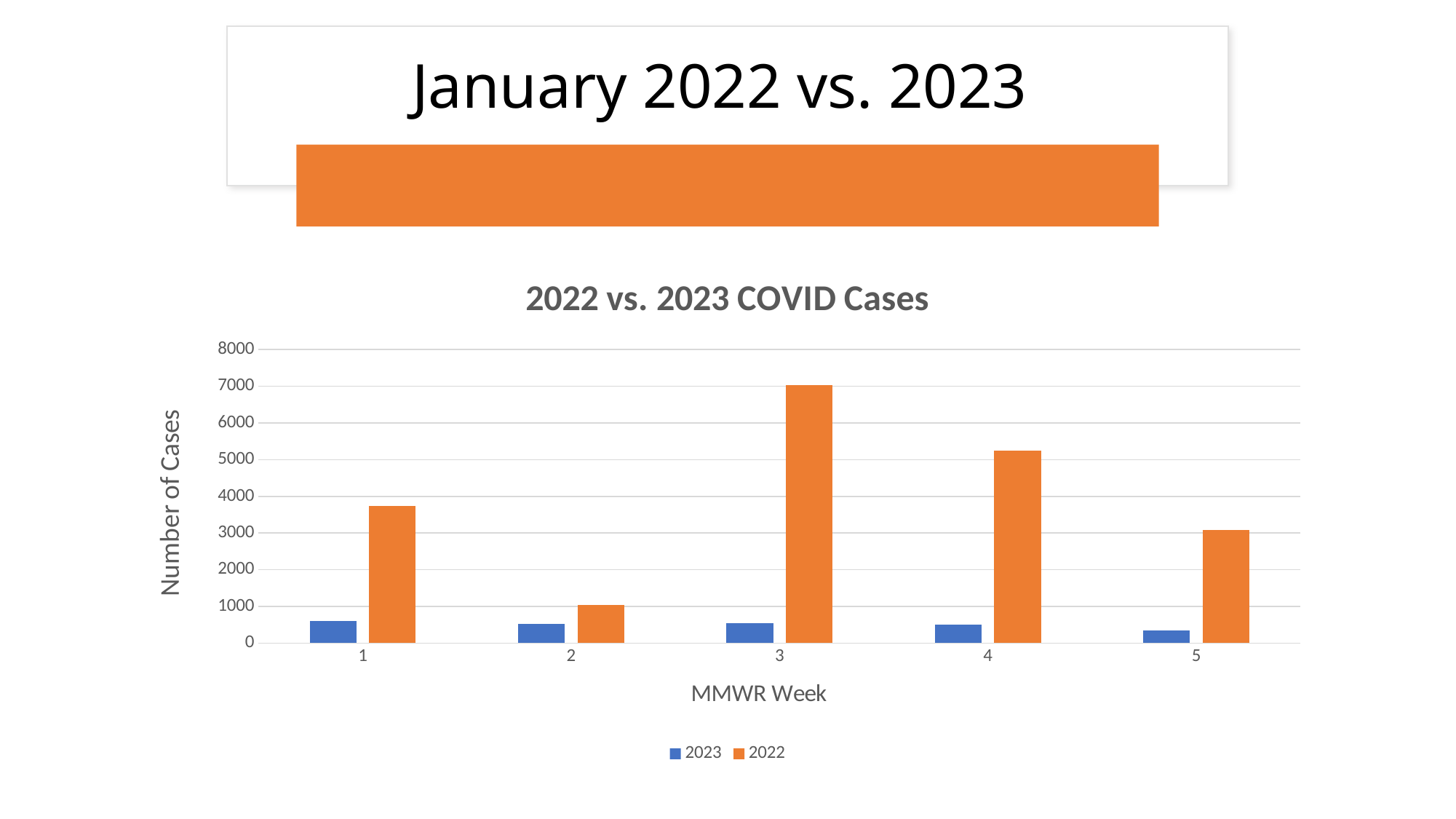
Is the 2022 value for MMWR week 1 greater or less than 4000? less What is the title of the chart? 2022 vs. 2023 COVID Cases Is the 2022 value for MMWR week 3 greater or less than 6000? greater How many series does the legend list? 2 In which MMWR week is the 2022 value highest? 3 What kind of chart is shown on the slide? bar chart In which MMWR week is the 2023 value lowest? 5 Is the 2023 value for MMWR week 1 greater or less than 1000? less Which is larger in MMWR week 4, the 2022 value or the 2023 value? 2022 In which MMWR week is the 2022 value lowest? 2 How many MMWR weeks are shown on the x axis? 5